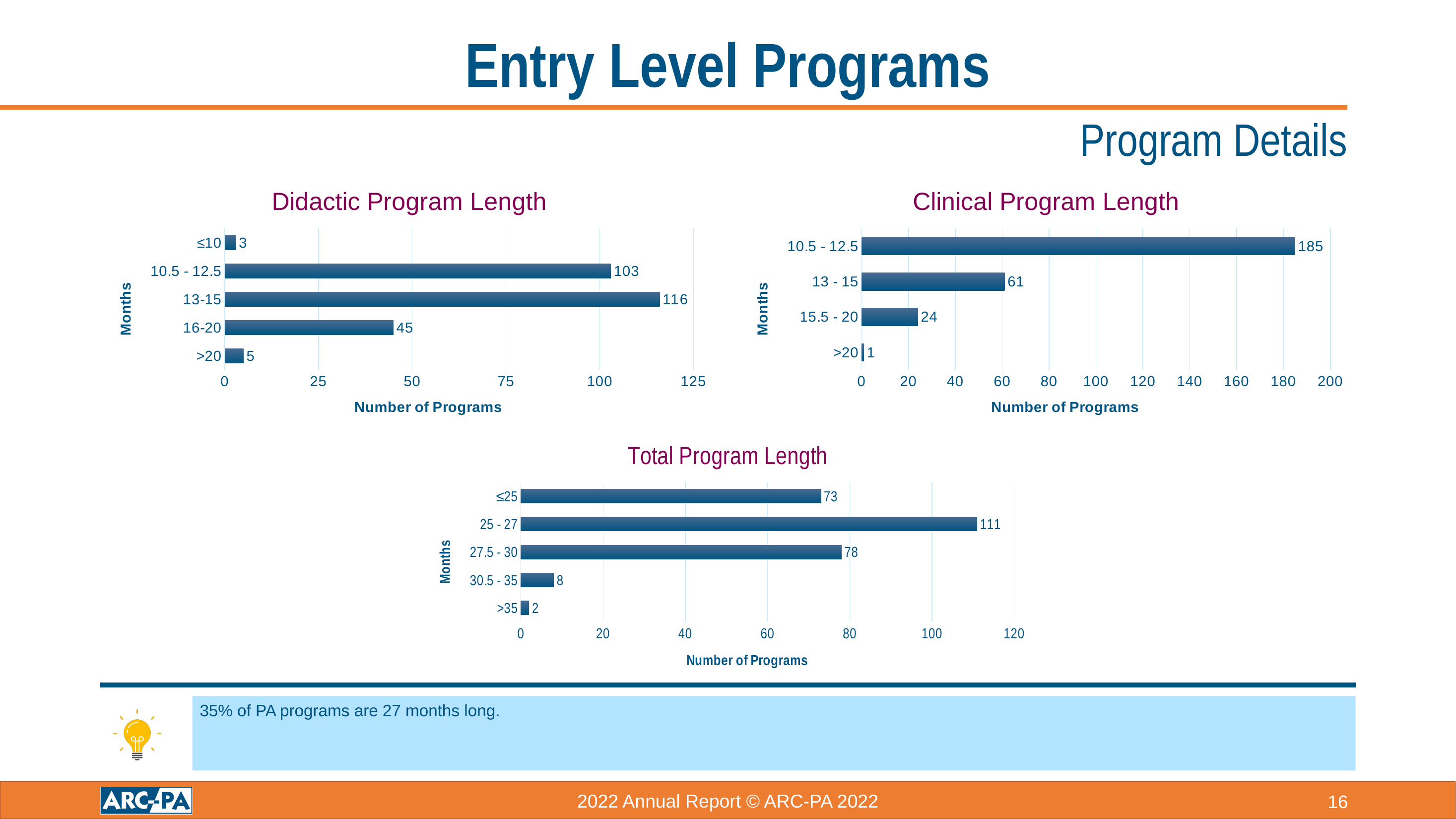
In the Clinical Program Length chart, which has more programs: 13 - 15 months or 15.5 - 20 months? 13 - 15 In the Clinical Program Length chart, how many programs have a clinical length of 10.5 - 12.5 months? 185 In the Clinical Program Length chart, which months category has the highest number of programs? 10.5 - 12.5 In the Total Program Length chart, how many programs have a total length of 25 - 27 months? 111 In the Didactic Program Length chart, what is the difference between the number of programs in the 13-15 and 10.5 - 12.5 categories? 13 In the Total Program Length chart, what is the difference between the number of programs in the 27.5 - 30 and ≤25 categories? 5 In the Total Program Length chart, how many months categories are shown? 5 In the Total Program Length chart, which months category has the highest number of programs? 25 - 27 In the Didactic Program Length chart, which months category has the lowest number of programs? ≤10 In the Didactic Program Length chart, how many programs have a didactic length of 13-15 months? 116 In the Clinical Program Length chart, how many months categories are shown? 4 What type of chart is the Didactic Program Length chart? Bar chart